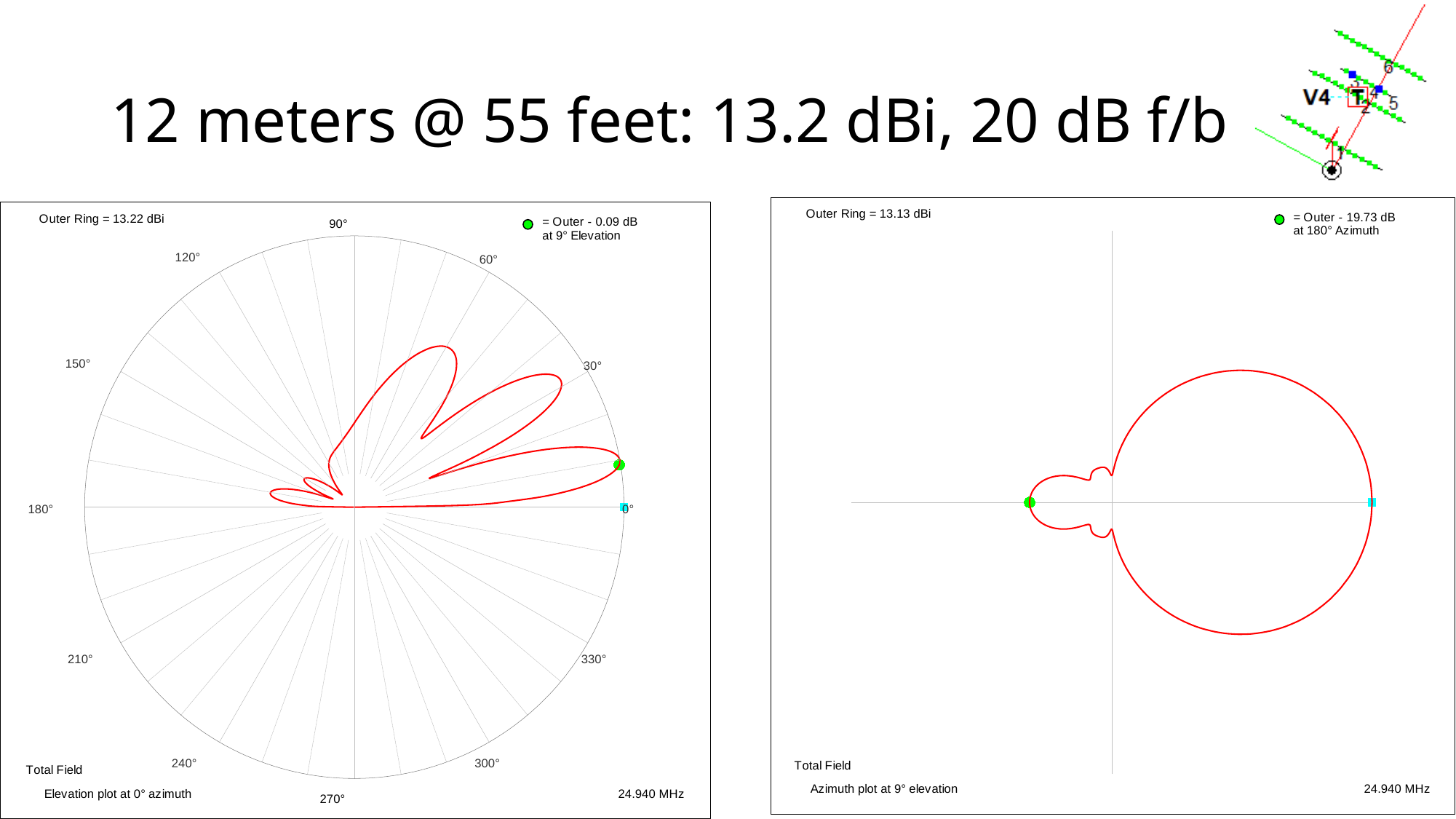
What frequency is shown on the left chart? 24.940 MHz What is the caption at the bottom left of the right chart describing the plot? Azimuth plot at 9° elevation On the left chart, how far below the outer ring is the green marker? 0.09 dB On the left chart (Elevation plot at 0° azimuth), what is the value of the outer ring? 13.22 dBi What field type is labelled on both charts? Total Field Which chart has the larger outer ring value, the left elevation plot or the right azimuth plot? the left elevation plot On the right chart (Azimuth plot at 9° elevation), what is the value of the outer ring? 13.13 dBi What kind of chart is the left plot? polar plot On the left chart, at what elevation angle is the green marker placed? 9° On the right chart, how far below the outer ring is the green marker? 19.73 dB On the right chart, at what azimuth is the green marker placed? 180° Azimuth What is the difference between the outer ring values of the left and right charts? 0.09 dBi